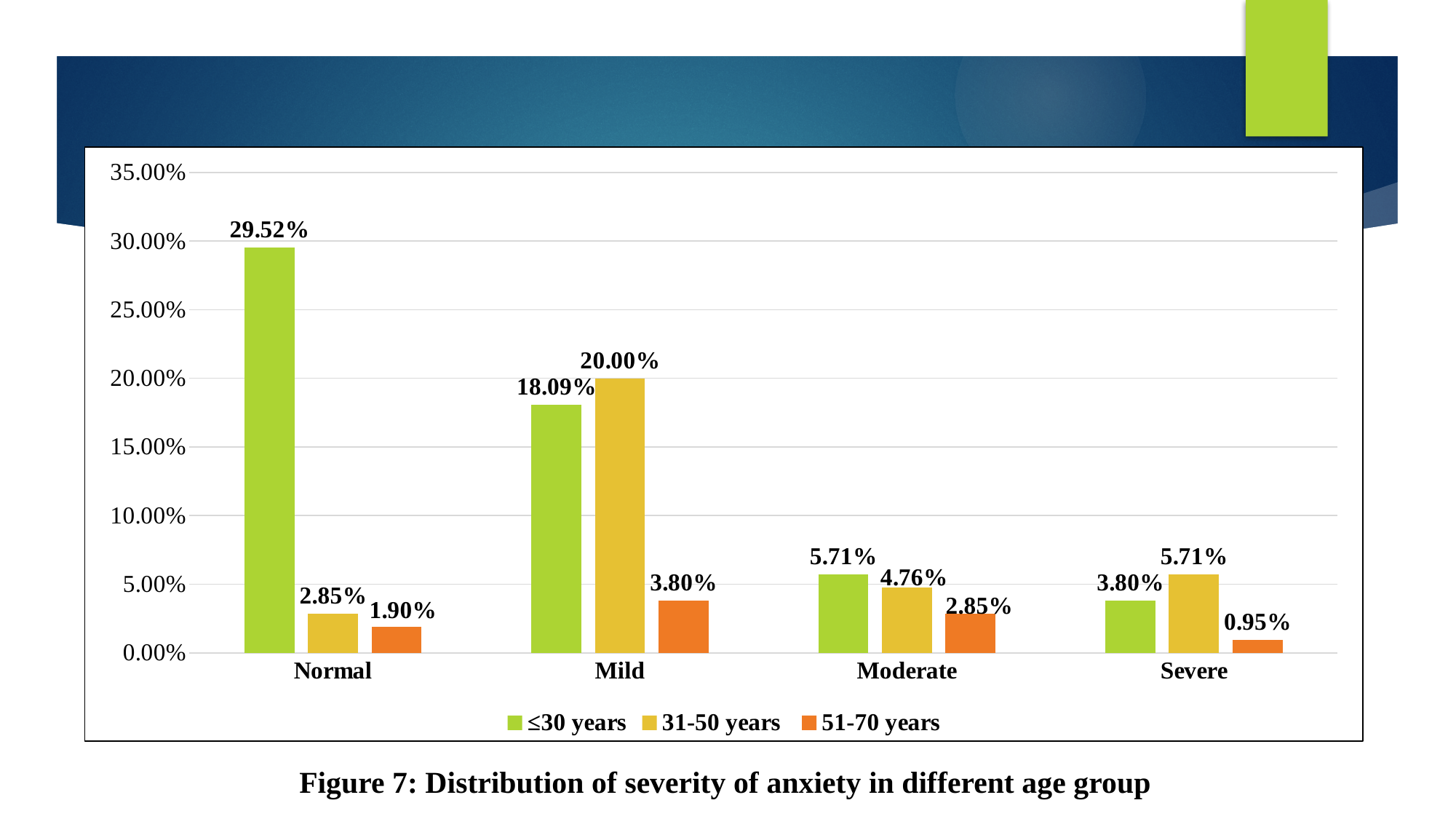
In the Mild category, which is larger: the ≤30 years value or the 31-50 years value? 31-50 years What is the difference between the ≤30 years value and the 31-50 years value in the Normal category? 26.67% Which category has the highest value for the ≤30 years series? Normal What kind of chart is shown on the slide? Bar chart How many series does the legend list? 3 Is the value for 31-50 years in the Moderate category greater or less than 5.00%? less What is the value for the 31-50 years series in the Mild category? 20.00% What is the figure caption below the chart? Figure 7: Distribution of severity of anxiety in different age group What is the value for the ≤30 years series in the Normal category? 29.52% Which category has the lowest value for the 51-70 years series? Severe How many severity categories are shown on the x axis? 4 What is the value for the 51-70 years series in the Severe category? 0.95%